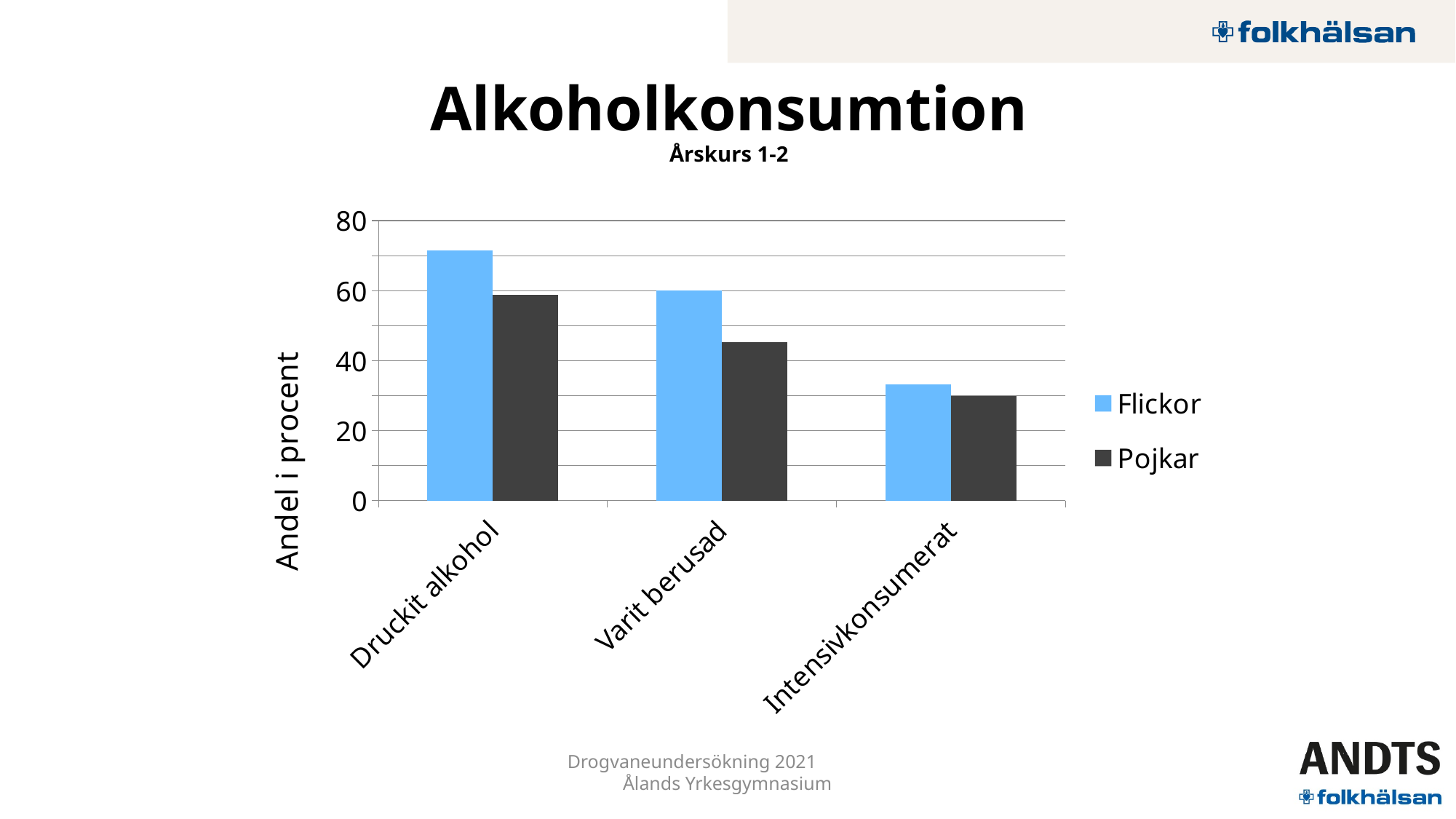
Is the value for Flickor in Druckit alkohol greater or less than 60? greater How many categories are shown on the x axis of the chart? 3 What is the label of the vertical axis of the chart? Andel i procent Which category has the lowest value for Pojkar? Intensivkonsumerat What kind of chart is shown on the slide? bar chart Is the value for Pojkar in Varit berusad greater or less than 60? less Is the value for Pojkar in Intensivkonsumerat greater or less than 20? greater Do the Flickor values rise or fall from Druckit alkohol to Intensivkonsumerat? fall For Druckit alkohol, which series has the larger value, Flickor or Pojkar? Flickor Which category has the highest value for Flickor? Druckit alkohol How many series does the legend list? 2 For Varit berusad, which series has the larger value, Flickor or Pojkar? Flickor